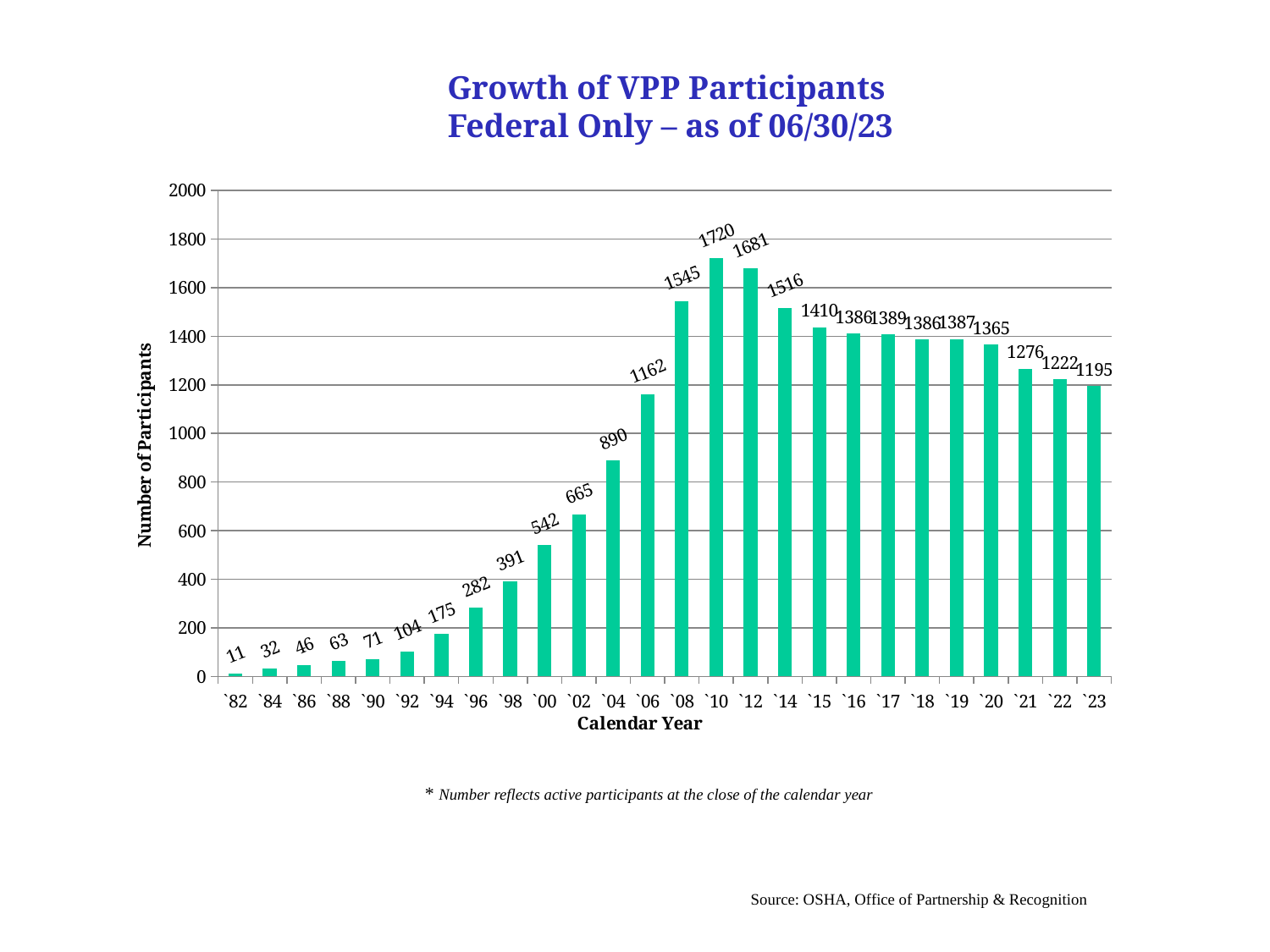
Do the values rise or fall from `82 to `10? Rise Which calendar year has the lowest number of participants? `82 What is the number of participants for `23? 1195 How many calendar years are shown on the x axis? 26 What is the number of participants for `10? 1720 What kind of chart is shown on the slide? Bar chart What is the difference in participants between `10 and `12? 39 Which year has more participants, `04 or `06? `06 What is the number of participants for `98? 391 What is the difference in participants between `08 and `06? 383 Which calendar year has the highest number of participants? `10 Is the value for `14 greater or less than 1400? greater